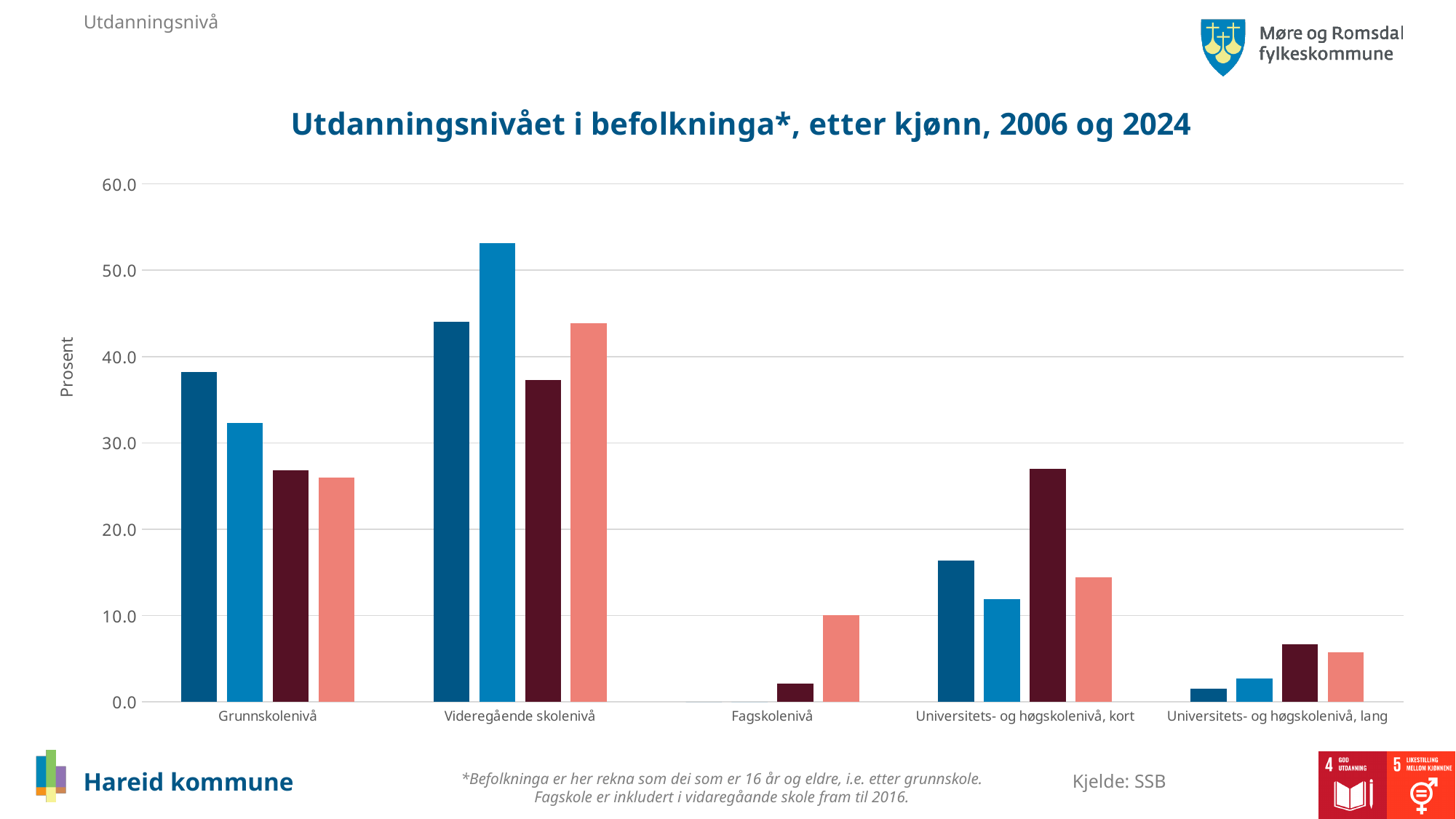
For Grunnskolenivå, which is larger: the dark blue (first) bar or the salmon (fourth) bar? the dark blue (first) bar What is the title of the chart? Utdanningsnivået i befolkninga*, etter kjønn, 2006 og 2024 How many bars are plotted for each category? 4 Is the value of the dark red (third) bar for Universitets- og høgskolenivå, kort greater or less than 20? greater Which category has the tallest bar in the chart? Videregående skolenivå What kind of chart is shown on the slide? bar chart How many education-level categories are shown on the x axis? 5 Is the value of the dark blue (first) bar for Grunnskolenivå greater or less than 40? less What is the label on the vertical axis? Prosent For Videregående skolenivå, which is larger: the dark blue (first) bar or the light blue (second) bar? the light blue (second) bar Is the value of the light blue (second) bar for Videregående skolenivå greater or less than 50? greater